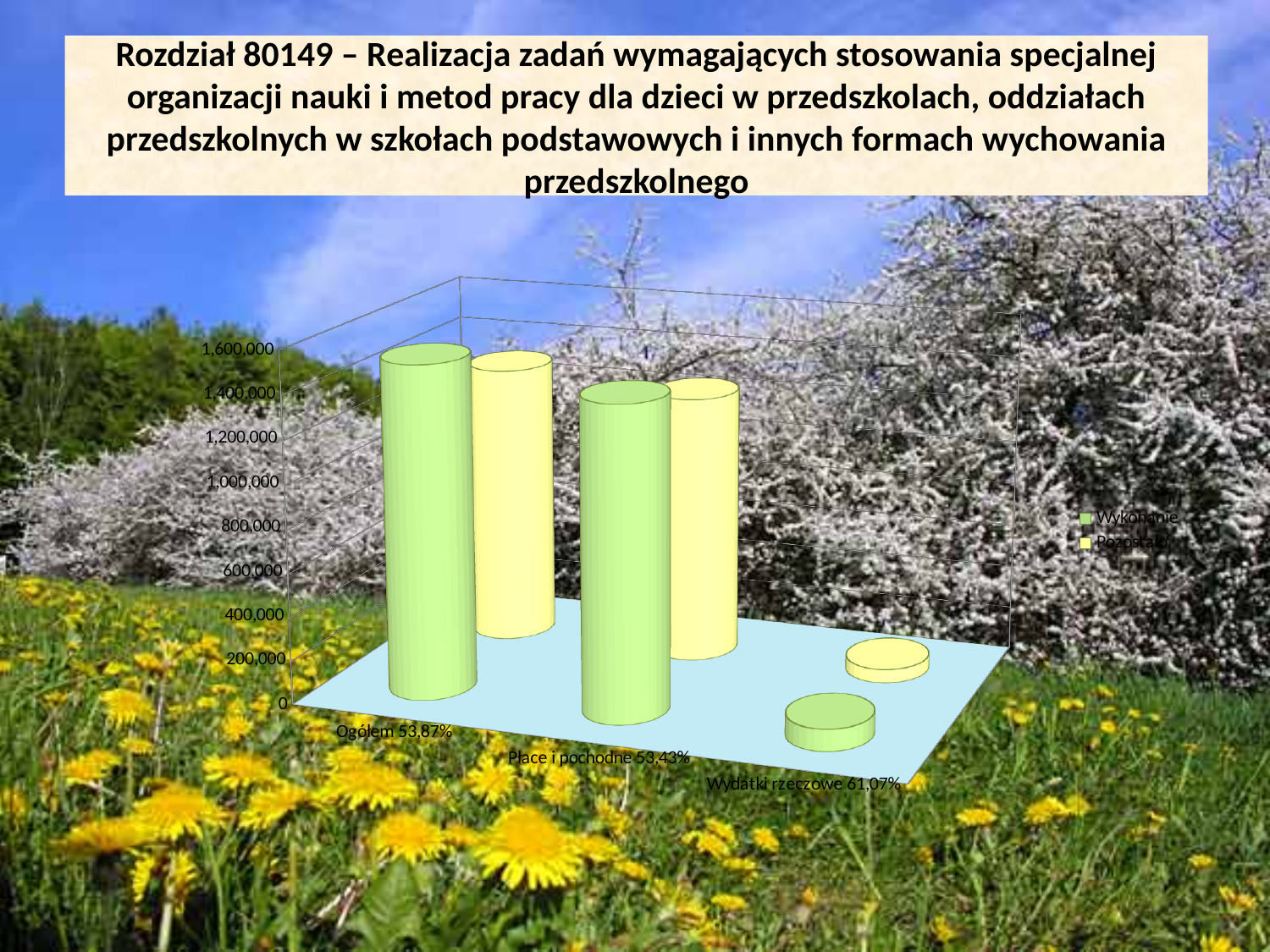
How many series does the legend list? 2 What percentage is printed in the category label for Wydatki rzeczowe? 61,07% What are the two series named in the legend? Wykonanie, Pozostało Which category has the highest Wykonanie value? Ogółem 53,87% Is the Pozostało value for Wydatki rzeczowe greater or less than 400,000? less Is the Pozostało value for Płace i pochodne greater or less than 800,000? greater Which is larger: the Wykonanie value for Ogółem or the Wykonanie value for Wydatki rzeczowe? Ogółem Is the Wykonanie value for Wydatki rzeczowe greater or less than 200,000? less What kind of chart is shown on the slide? bar chart How many categories are shown on the x axis of the chart? 3 Which category has the lowest values for both series? Wydatki rzeczowe 61,07%